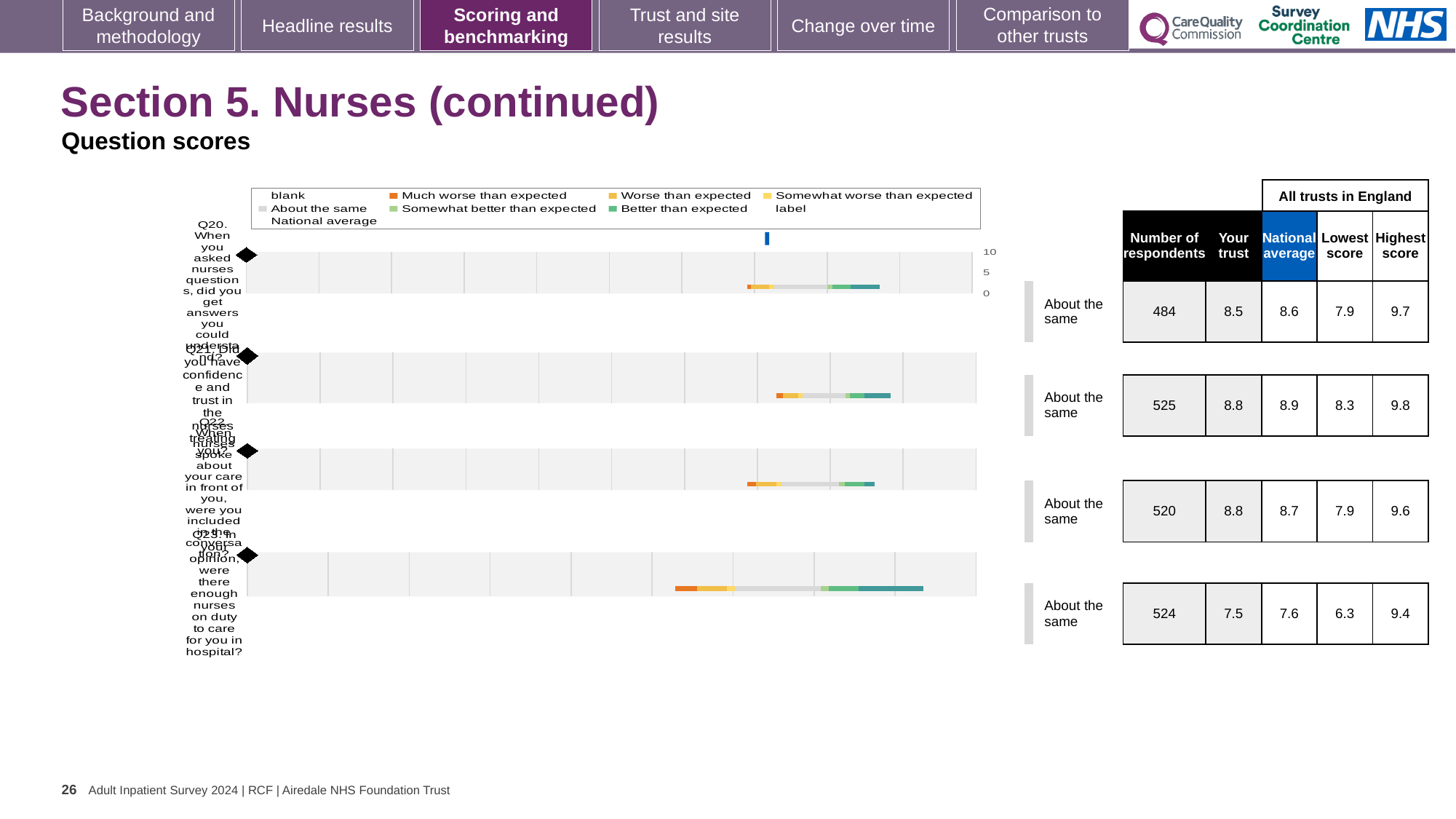
According to the table beside the chart, what is the number of respondents for Q21? 525 What is the highest value shown on the chart's score axis? 10 What benchmark category is shown beside the chart for Q23? About the same How many survey questions (categories) are plotted in the chart? 4 Which question has the highest number of respondents in the table beside the chart? Q21 For Q23, what is the difference between the highest score (9.4) and the lowest score (6.3) in the table beside the chart? 3.1 What kind of chart is shown on the slide? bar chart For Q22, which is larger in the table beside the chart: the 'Your trust' score or the national average? Your trust According to the table beside the chart, what is the 'Your trust' score for Q20? 8.5 According to the table beside the chart, what is the national average for Q23? 7.6 According to the table beside the chart, what is the highest score among all trusts in England for Q22? 9.6 Which question has the lowest 'Your trust' score in the table beside the chart? Q23